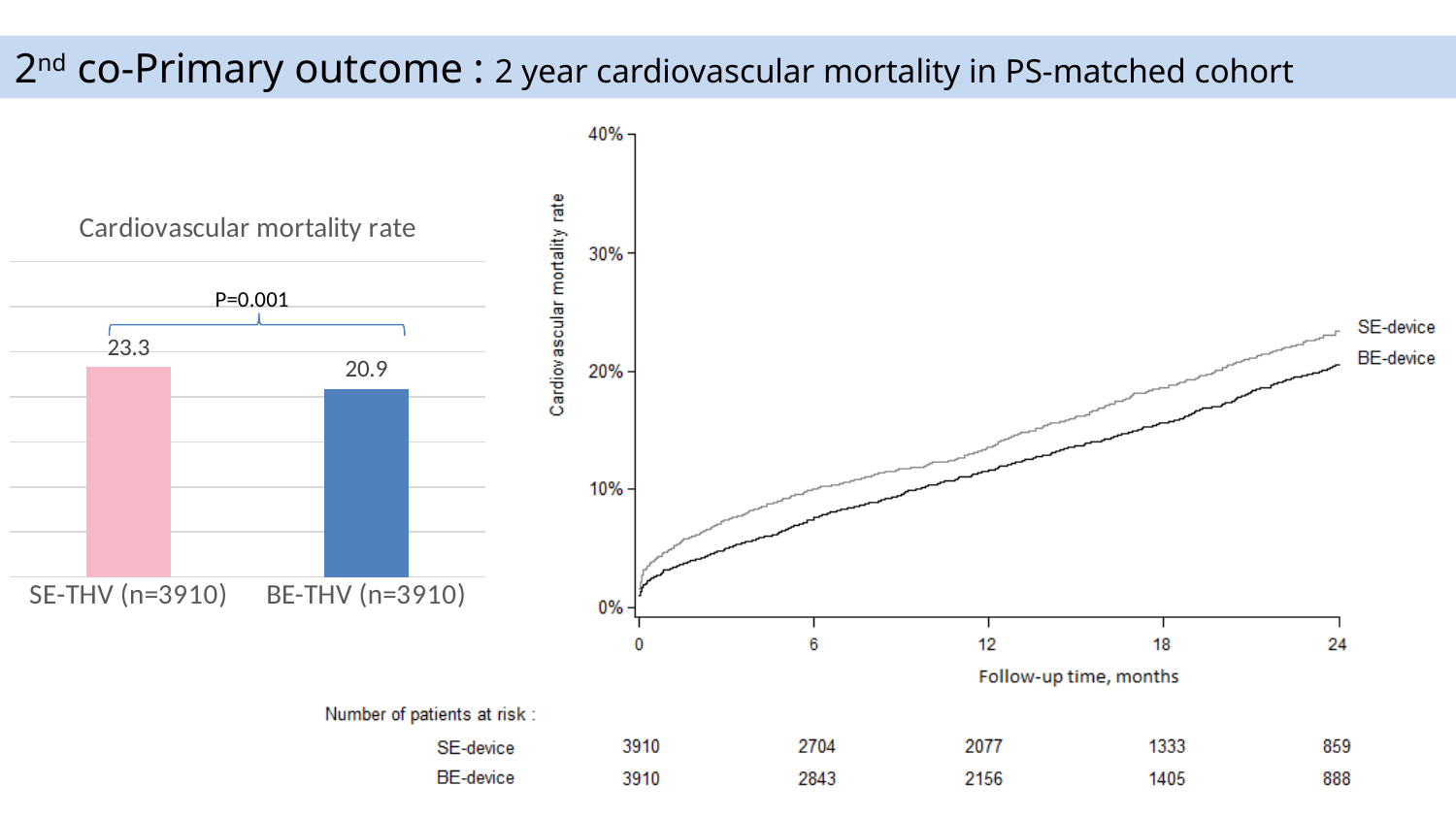
In the 'Cardiovascular mortality rate' bar chart, what is the value for BE-THV (n=3910)? 20.9 In the 'Cardiovascular mortality rate' bar chart, how many bars are shown? 2 What kind of chart is the chart on the right of the slide? Line chart In the 'Cardiovascular mortality rate' bar chart, what P value is shown between the two bars? P=0.001 What kind of chart is the chart on the left of the slide? Bar chart In the 'Cardiovascular mortality rate' bar chart, what is the difference between the SE-THV and BE-THV values? 2.4 In the 'Cardiovascular mortality rate' bar chart, which category has the lower value? BE-THV (n=3910) In the 'Cardiovascular mortality rate' bar chart, which category has the higher value? SE-THV (n=3910) In the line chart on the right, is the SE-device value at 24 months greater or less than 20%? greater In the line chart on the right, do the cardiovascular mortality rates rise or fall as follow-up time increases? Rise In the line chart on the right, how many series are plotted? 2 In the 'Cardiovascular mortality rate' bar chart, what is the value for SE-THV (n=3910)? 23.3